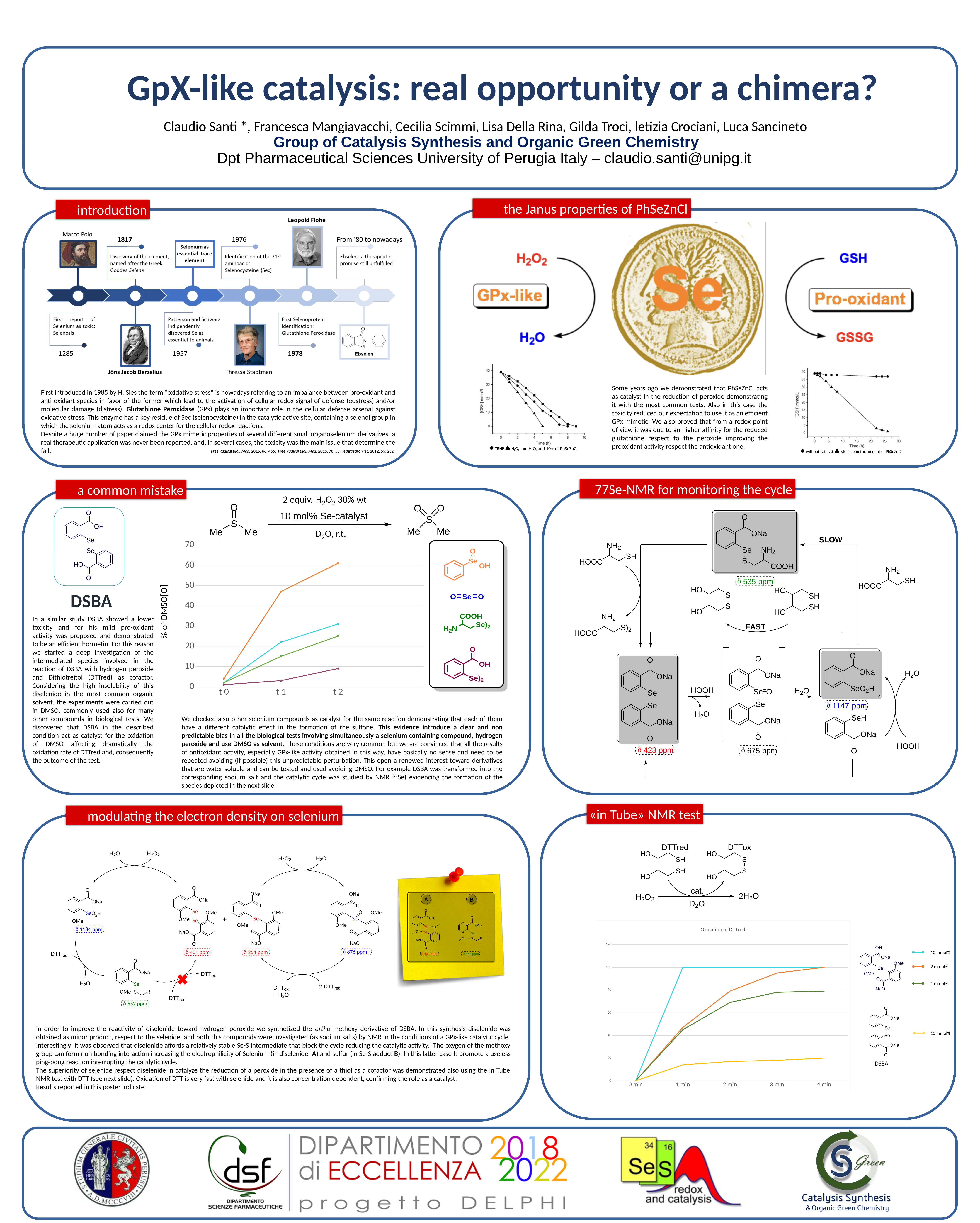
In the 'a common mistake' chart, which line has the highest value at t 2? the orange line In the 'Oxidation of DTTred' chart, how many time points are shown on the x axis? 5 In the 'Oxidation of DTTred' chart, do the series values rise or fall from 0 min to 4 min? rise In the 'Oxidation of DTTred' chart, which series has the lowest value at 4 min? DSBA 10 mmol% (yellow) In the 'Oxidation of DTTred' chart, what kind of chart is shown? line chart In the 'a common mistake' chart, how many categories are on the x axis? 3 In the 'Oxidation of DTTred' chart, is the value of the DSBA 10 mmol% (yellow) series at 4 min greater or less than 40? less In the «in Tube» NMR test section, what is the title of the chart? Oxidation of DTTred In the 'a common mistake' section, what is the y-axis label of the chart? % of DMSO[O] In the 'Oxidation of DTTred' chart, how many series does the legend list? 4 In the 'Oxidation of DTTred' chart, is the value of the 10 mmol% (cyan) series at 1 min greater or less than 80? greater In the 'a common mistake' chart, is the value of the orange line at t 2 greater or less than 50? greater